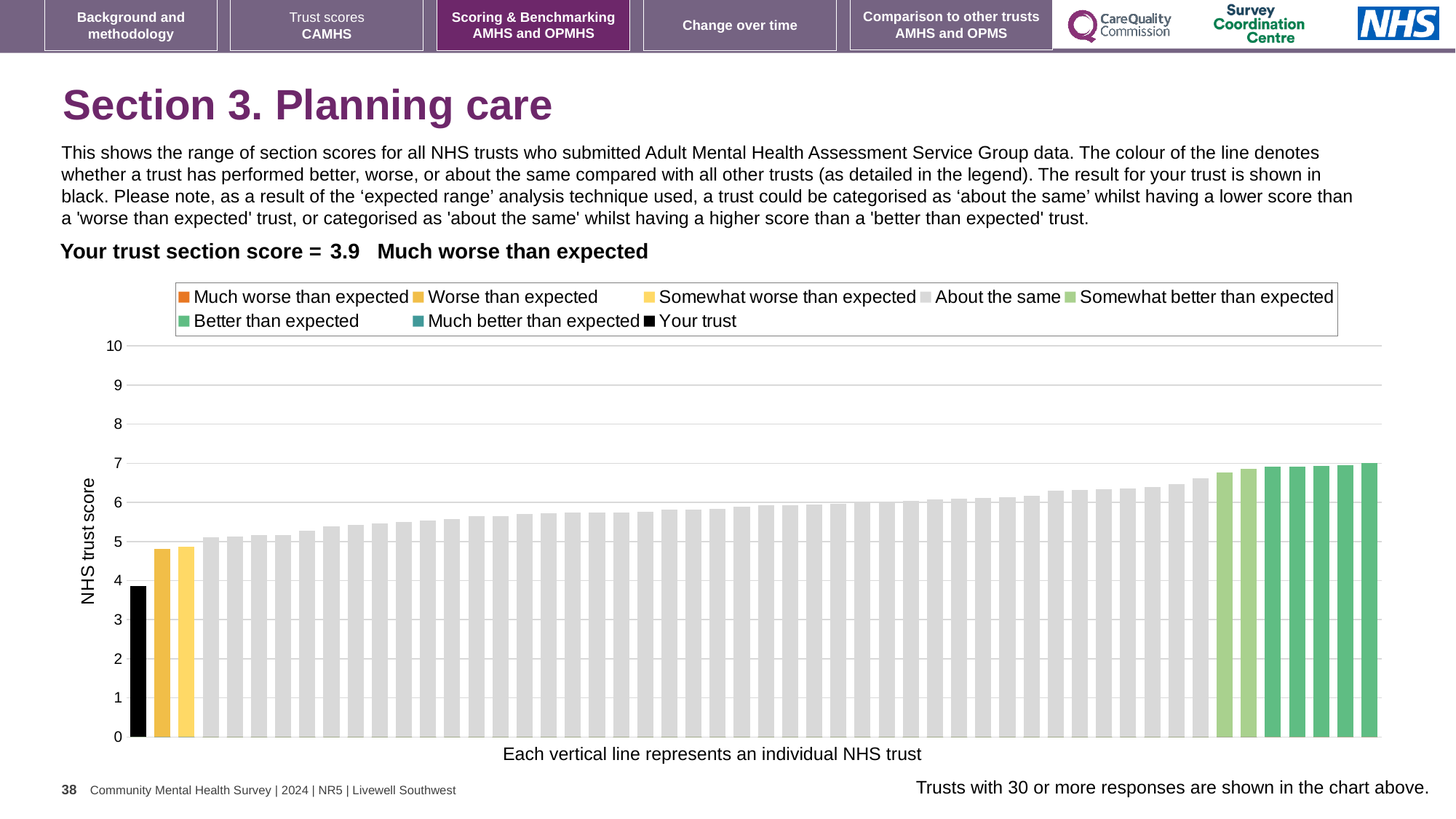
Do the bar values rise or fall from left to right along the x axis? rise Is the value of the highest bar greater or less than 6? greater Which category is your trust's section score placed in? Much worse than expected What is the label on the y axis? NHS trust score What is the section score for your trust? 3.9 How many bars are coloured as 'Better than expected'? 5 Which bar is the lowest in the chart? Your trust What kind of chart is shown on the slide? bar chart What colour represents 'Your trust' in the legend? black Is the value for your trust greater or less than 5? less How many entries does the chart legend list? 8 Are the values of the yellow 'Worse than expected' bars greater or less than 5? less